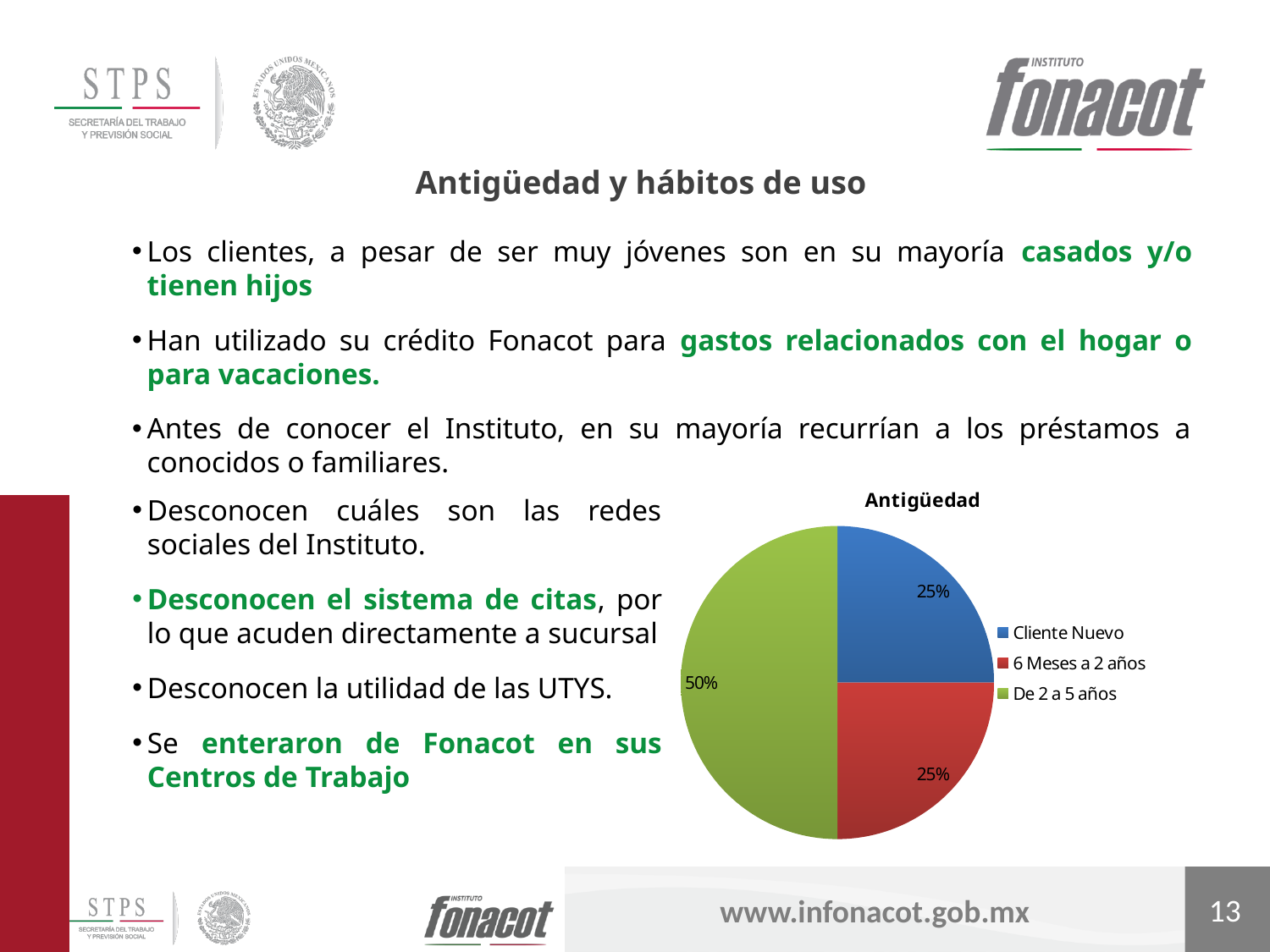
How many slices does the pie chart have? 3 How many entries does the legend list? 3 What percentage of the pie does "De 2 a 5 años" represent? 50% Which category has the largest slice of the pie? De 2 a 5 años Which is larger, the slice for "De 2 a 5 años" or the slice for "Cliente Nuevo"? De 2 a 5 años What is the difference in percentage points between the "De 2 a 5 años" slice and the "6 Meses a 2 años" slice? 25% What percentage of the pie does "Cliente Nuevo" represent? 25% What type of chart is shown on the slide? pie chart What colour is the slice for "De 2 a 5 años"? green What is the title of the chart? Antigüedad What percentage of the pie does "6 Meses a 2 años" represent? 25% What share of the pie is taken by "Cliente Nuevo" and "6 Meses a 2 años" combined? 50%